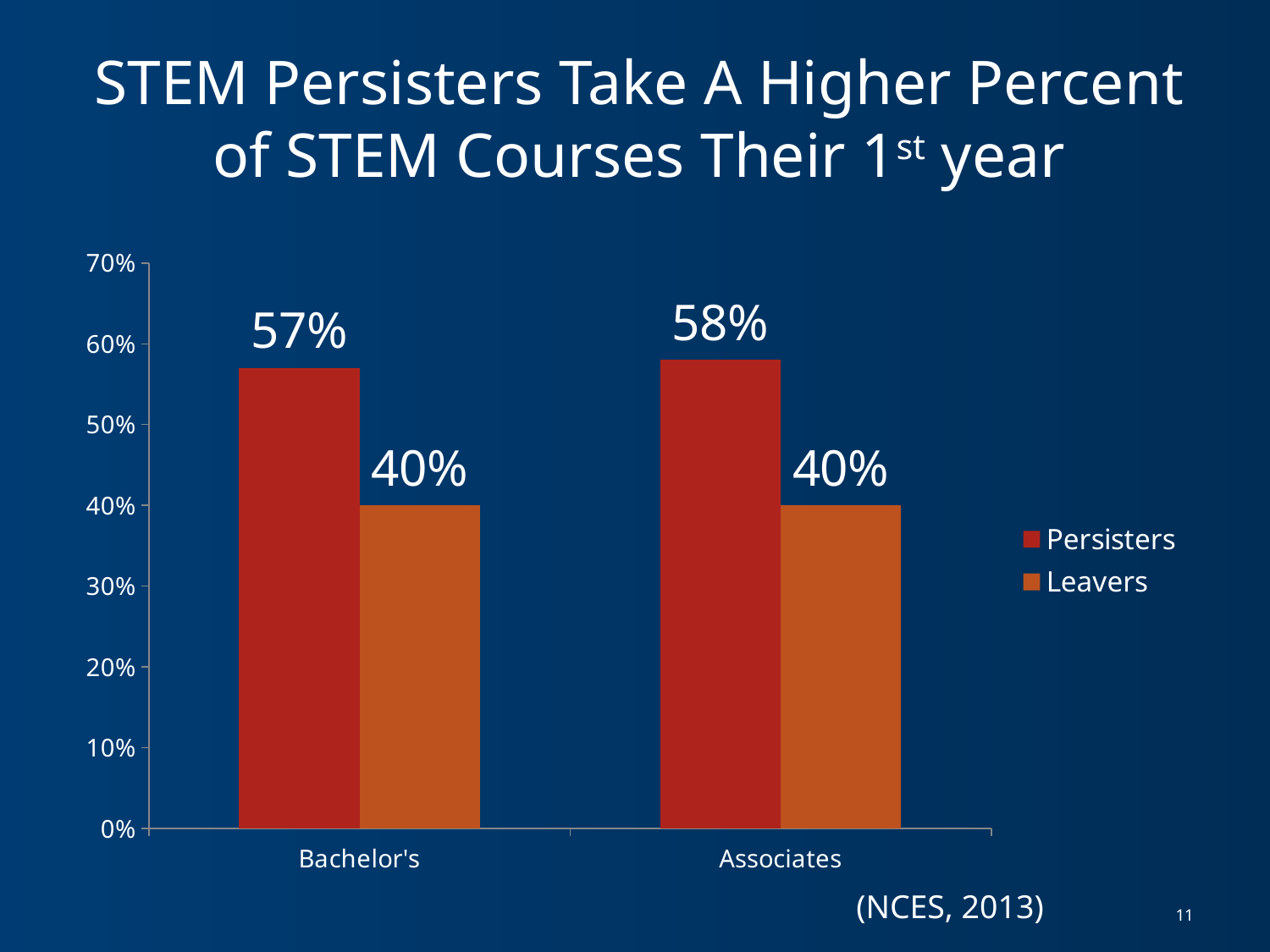
What is the value for Leavers in the Bachelor's category? 40% What is the value for Persisters in the Associates category? 58% How many categories are shown on the x axis? 2 What is the value for Leavers in the Associates category? 40% Which is larger in the Associates category, Persisters or Leavers? Persisters How many series does the legend list? 2 What is the difference between Persisters and Leavers in the Associates category? 18% Which category has the highest Persisters value? Associates Is the value for Persisters in the Bachelor's category greater or less than 50%? greater What kind of chart is shown on the slide? Bar chart What is the difference between Persisters and Leavers in the Bachelor's category? 17% What is the value for Persisters in the Bachelor's category? 57%